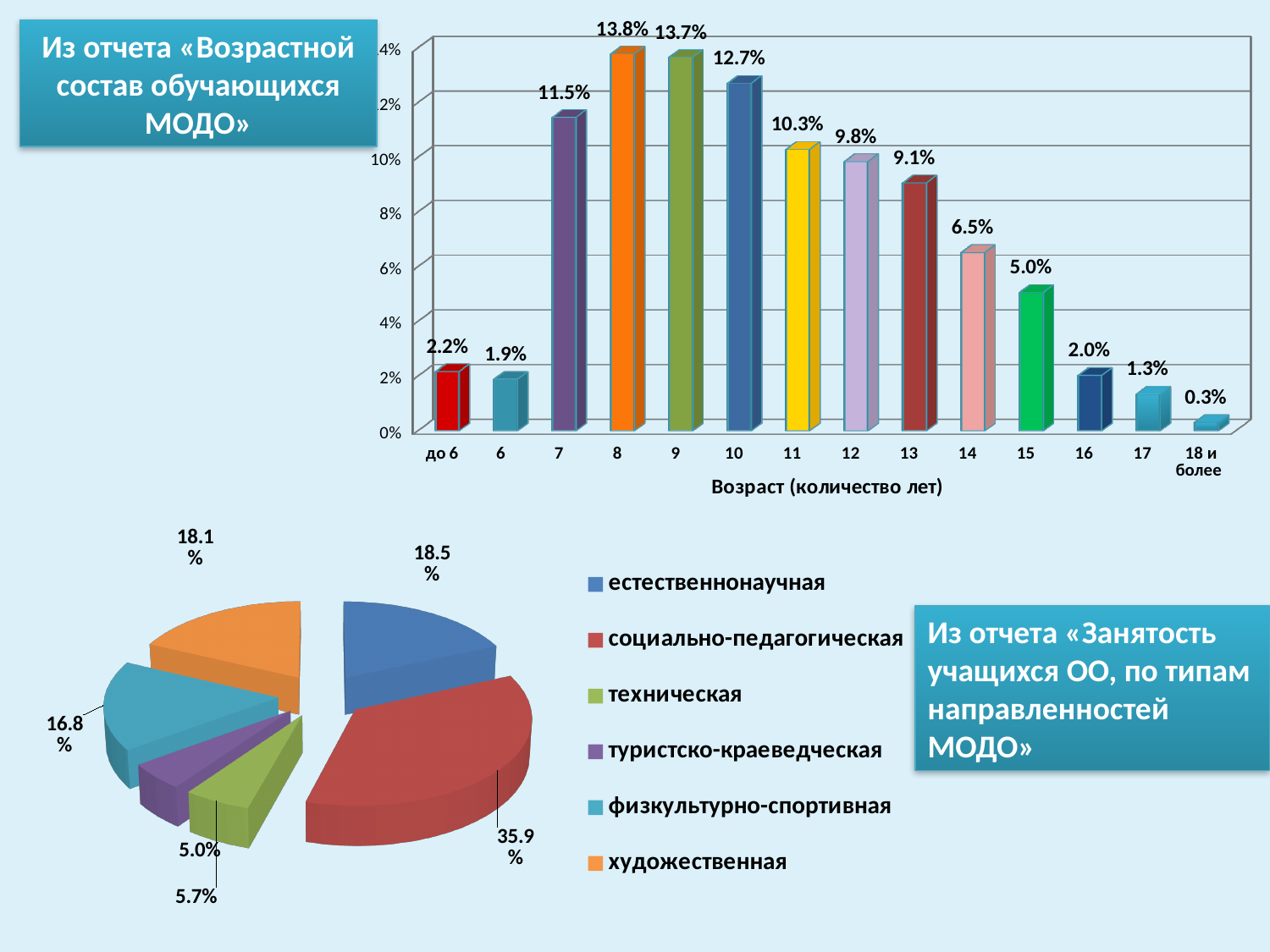
In the bar chart at the top, how many age categories are shown on the x axis? 14 How many entries does the legend of the pie chart at the bottom list? 6 In the bar chart at the top, what is the value for age 14? 6.5% In the bar chart at the top, do the values rise or fall from age 9 to age 17? fall In the bar chart at the top, which is larger, the value for age 7 or the value for age 12? 7 In the bar chart at the top, which age category has the highest value? 8 In the bar chart at the top, what is the value for age 8? 13.8% In the bar chart at the top, what is the difference between the values for age 10 and age 11? 2.4% In the bar chart at the top, which age category has the lowest value? 18 и более In the pie chart at the bottom, which category has the largest slice? социально-педагогическая In the pie chart at the bottom, what share does социально-педагогическая have? 35.9% What kind of chart is the chart at the top of the slide? bar chart